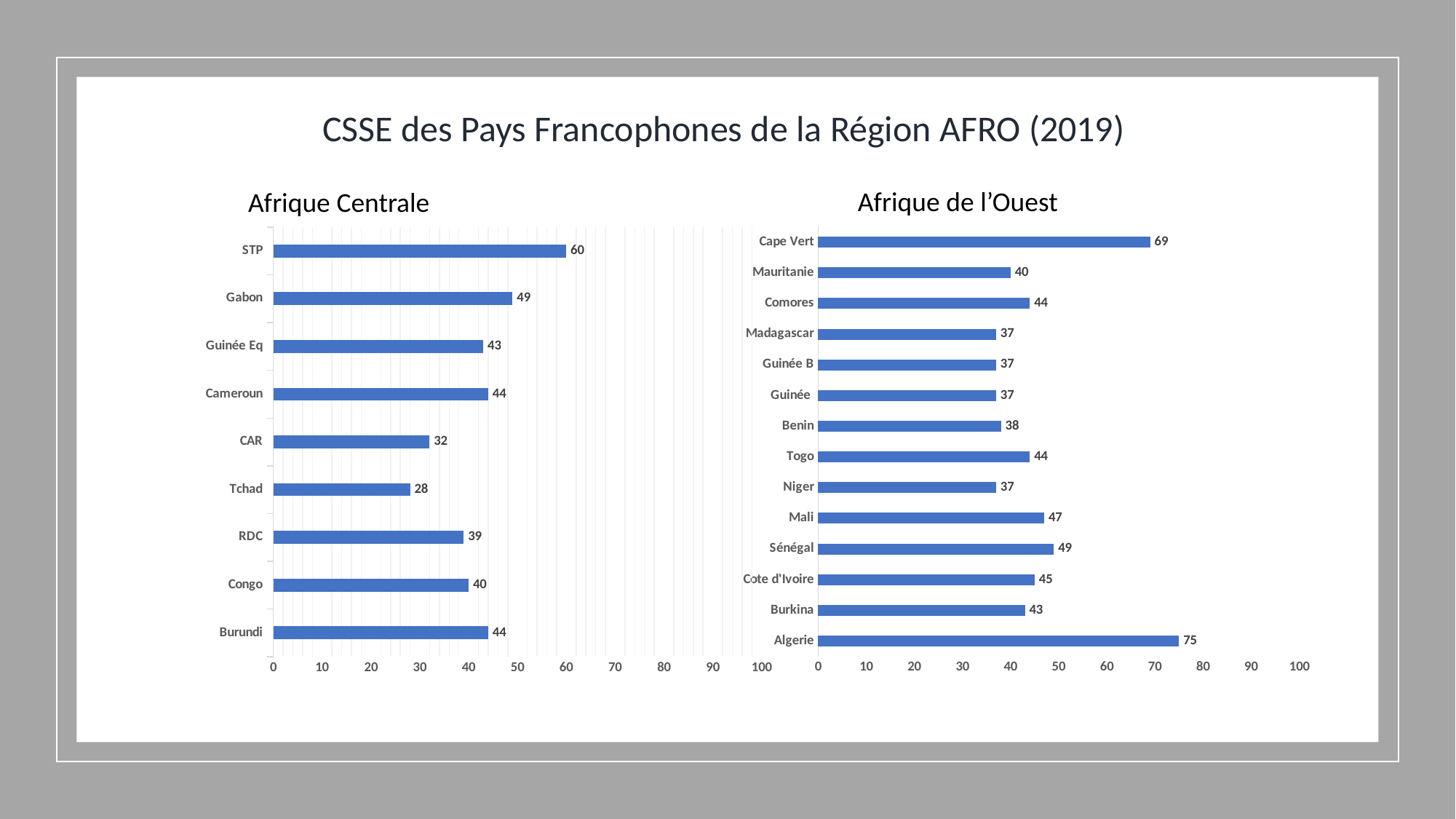
In the Afrique de l'Ouest chart, what is the value for Algerie? 75 In the Afrique de l'Ouest chart, what is the value for Sénégal? 49 In the Afrique de l'Ouest chart, which is larger, the value for Mali or the value for Benin? Mali In the Afrique Centrale chart, how many countries are shown? 9 In the Afrique Centrale chart, what is the value for STP? 60 In the Afrique Centrale chart, which country has the lowest value? Tchad In the Afrique de l'Ouest chart, which country has the highest value? Algerie What type of chart is the Afrique Centrale chart? Bar chart In the Afrique Centrale chart, which country has the highest value? STP In the Afrique Centrale chart, what is the difference between the values for Gabon and CAR? 17 In the Afrique de l'Ouest chart, how many countries are shown? 14 In the Afrique de l'Ouest chart, what is the difference between the values for Cape Vert and Mauritanie? 29